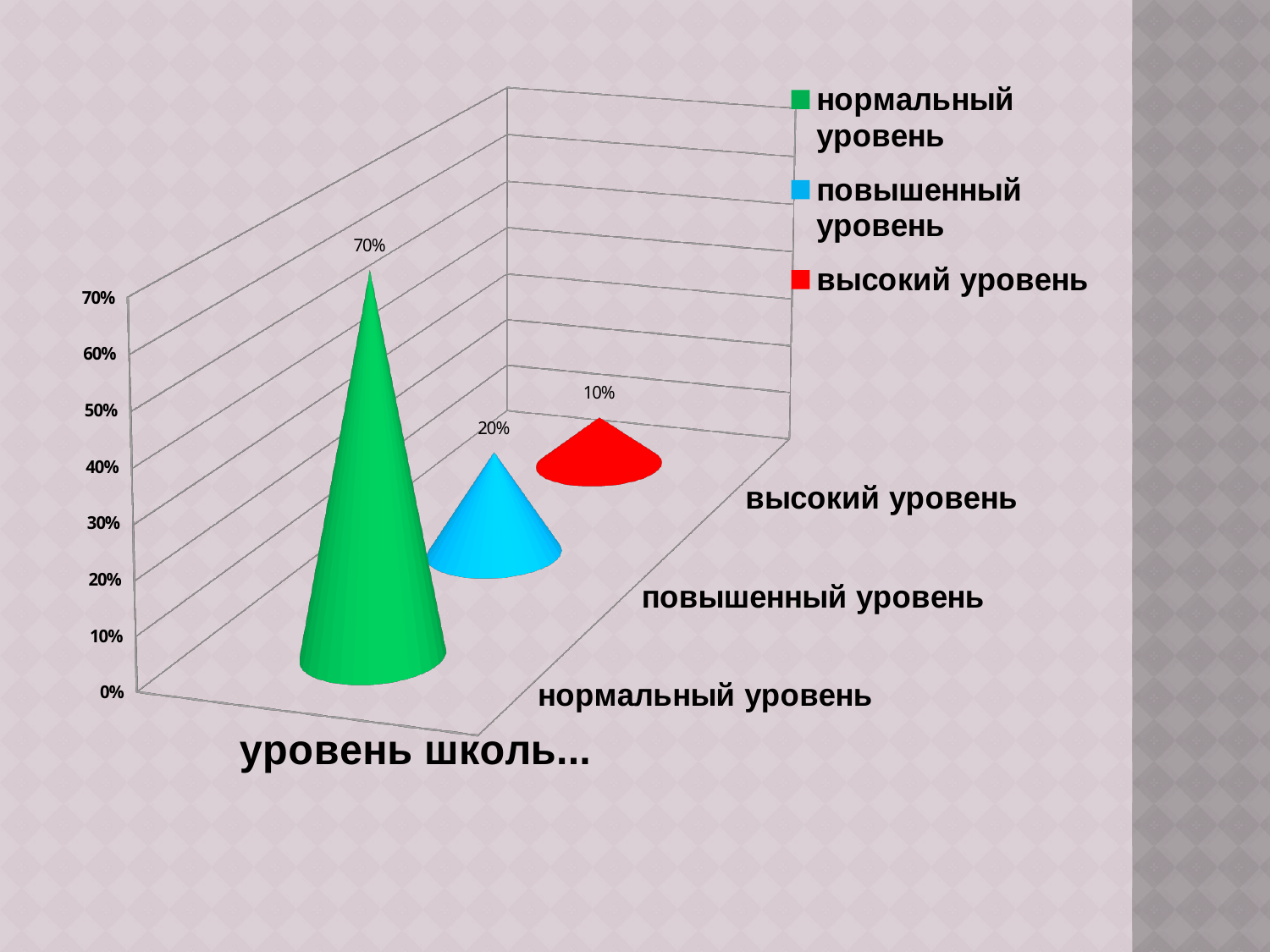
What is the value for высокий уровень? 10% What is the value for нормальный уровень? 70% How many entries does the legend list? 3 Is the value for нормальный уровень greater or less than 50%? greater What is the difference between the values for повышенный уровень and высокий уровень? 10% What is the difference between the values for нормальный уровень and повышенный уровень? 50% What kind of chart is shown on the slide? bar chart Which category has the lowest value? высокий уровень Which category has the highest value? нормальный уровень How many categories are shown in the chart? 3 What is the value for повышенный уровень? 20% Which is larger, the value for повышенный уровень or the value for высокий уровень? повышенный уровень